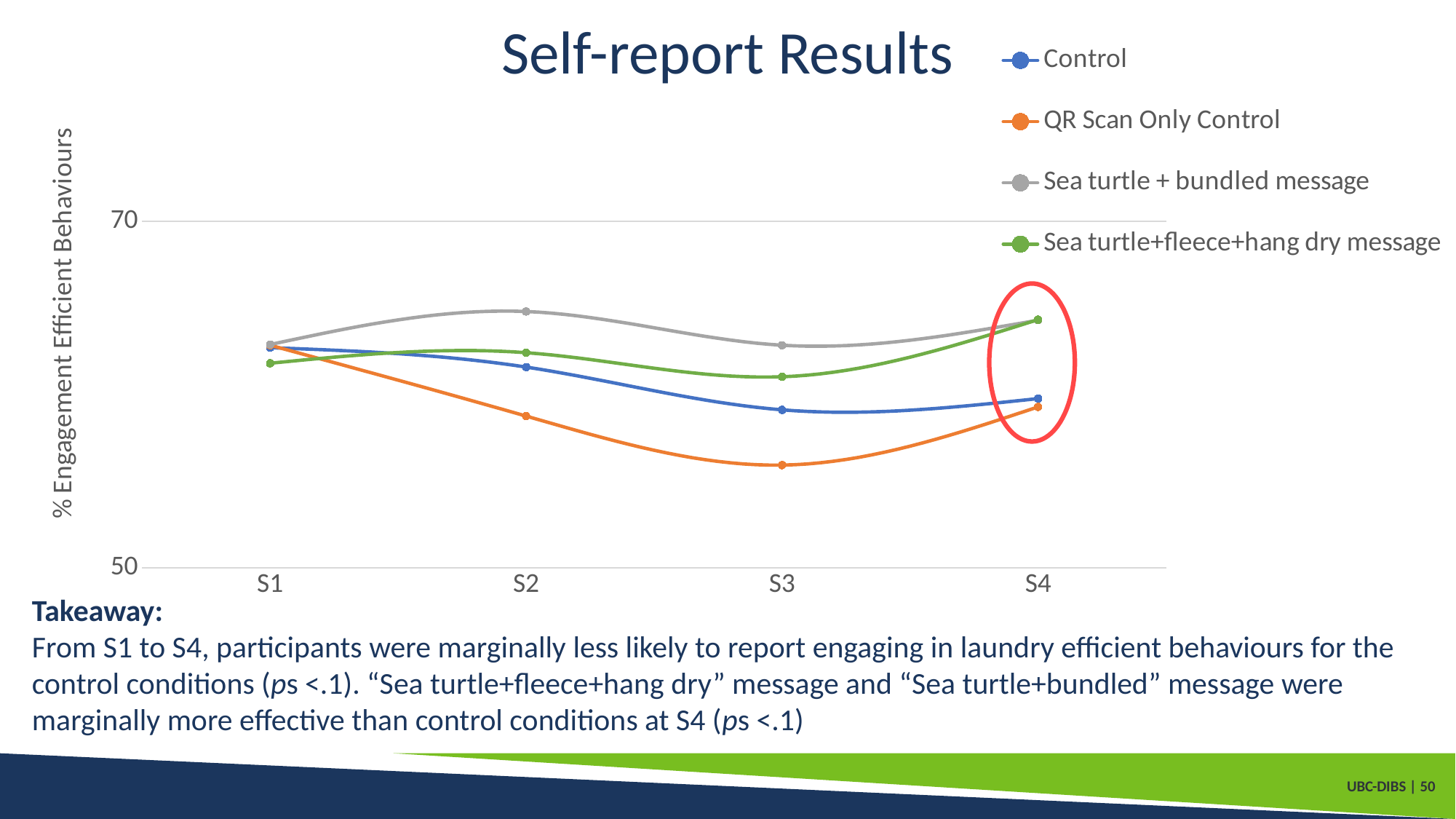
At S4, which is larger: the value for Sea turtle+fleece+hang dry message or the value for Control? Sea turtle+fleece+hang dry message Which series has the lowest value at S3? QR Scan Only Control How many series does the legend list? 4 How many categories are shown on the x axis? 4 At S3, which is larger: the value for Sea turtle + bundled message or the value for QR Scan Only Control? Sea turtle + bundled message What is the label of the y axis? % Engagement Efficient Behaviours What kind of chart is shown on the slide? line chart Which series has the highest value at S2? Sea turtle + bundled message Is the value for Sea turtle + bundled message at S2 greater or less than 70? less Does the value for QR Scan Only Control rise or fall from S1 to S3? fall Does the value for Sea turtle+fleece+hang dry message rise or fall from S3 to S4? rise Which series has the lowest value at S4? QR Scan Only Control